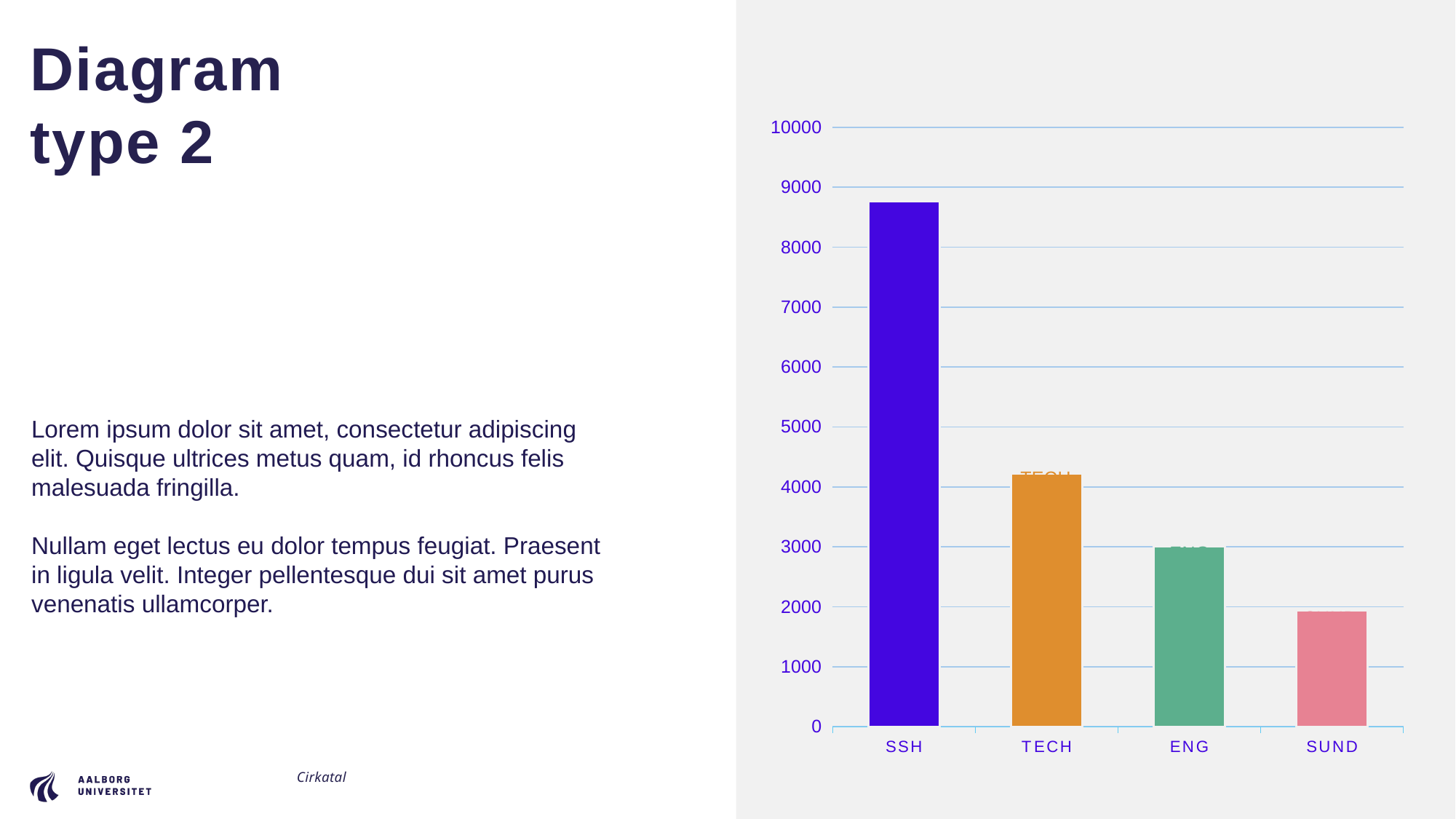
Is the value for TECH greater or less than 4000? greater Which is larger, the value for ENG or the value for SUND? ENG Which is larger, the value for SSH or the value for TECH? SSH What kind of chart is shown on the slide? bar chart Is the value for TECH greater or less than 5000? less How many categories are shown on the x axis of the chart? 4 Is the value for SSH greater or less than 8000? greater Which category has the highest bar in the chart? SSH Which category has the lowest bar in the chart? SUND What is the highest value shown on the chart's vertical axis? 10000 Do the bar values rise or fall from left to right across the x axis? fall